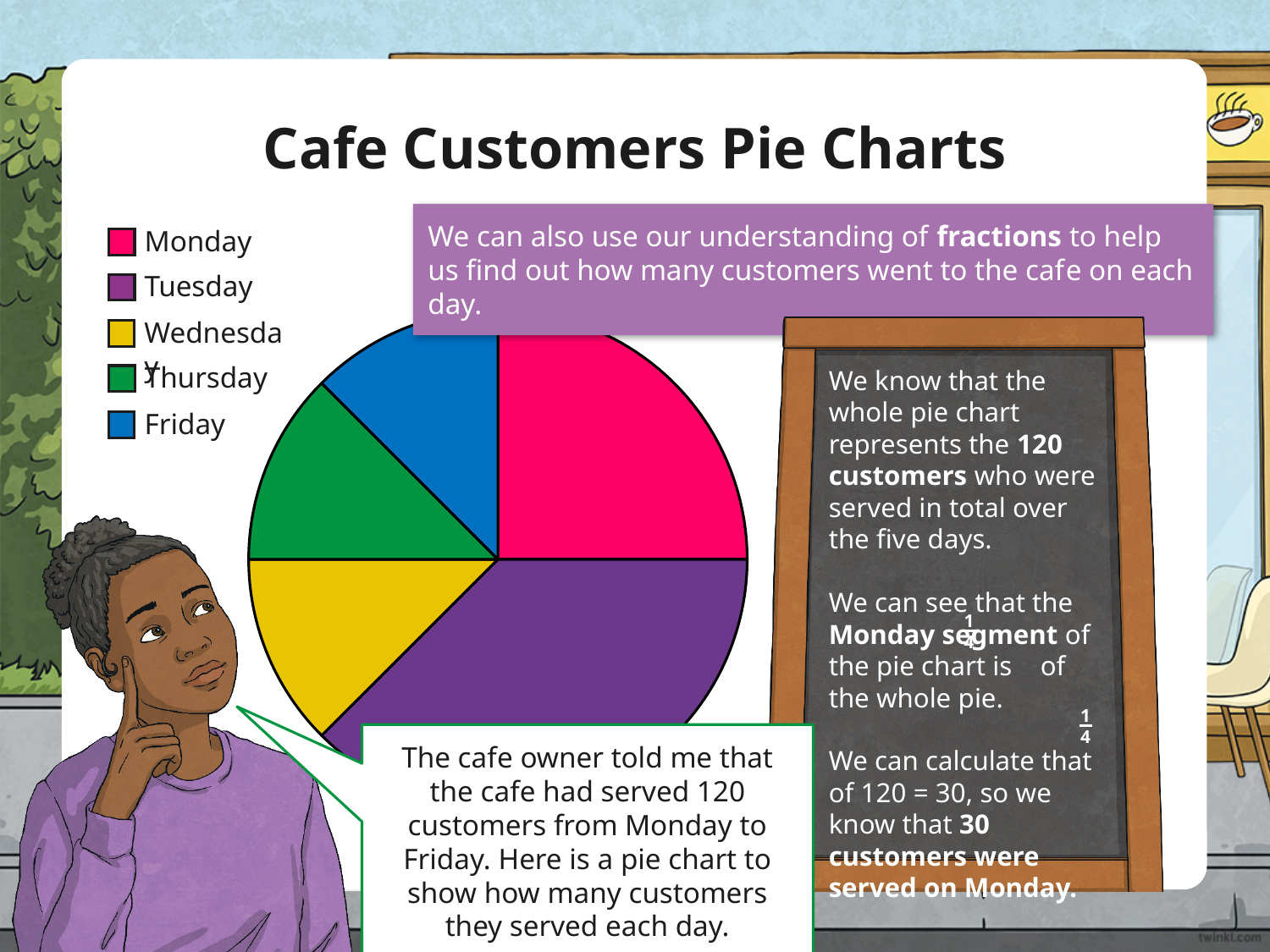
How many entries does the legend list? 5 Which day has the largest segment in the pie chart? Tuesday Which segment is larger, Tuesday or Friday? Tuesday What fraction of the whole pie does the Monday segment represent? 1/4 What is the title of the slide? Cafe Customers Pie Charts How many customers in total does the whole pie chart represent? 120 Which segment is larger, Monday or Wednesday? Monday How many customers were served on Monday? 30 What kind of chart is shown on the slide? pie chart Which day is shown in blue in the pie chart? Friday How many segments does the pie chart have? 5